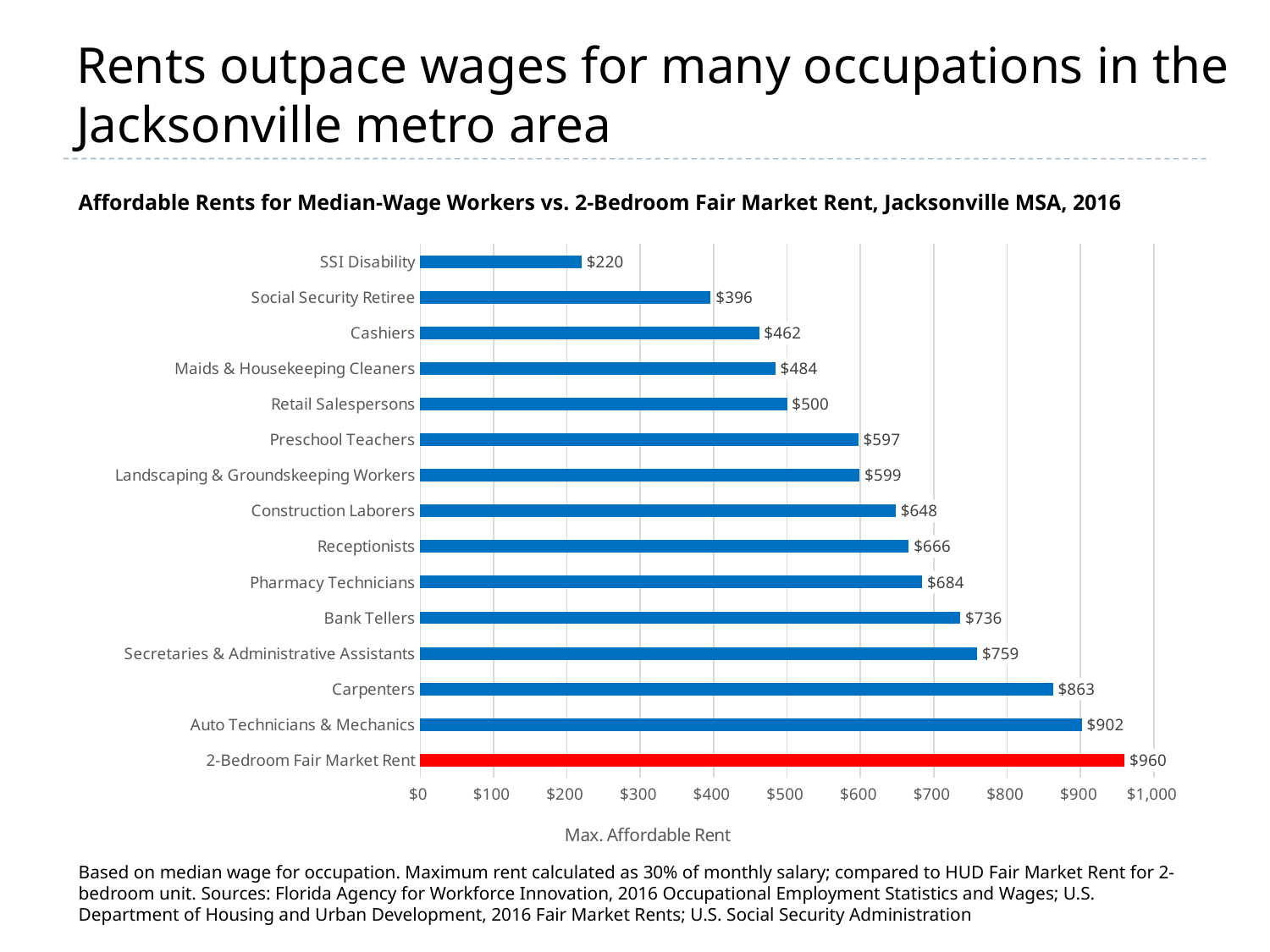
Which is larger, the value for Preschool Teachers or the value for Construction Laborers? Construction Laborers How many categories are plotted on the chart? 15 What kind of chart is shown on the slide? Bar chart What is the difference between the values for Carpenters and Receptionists? $197 Which category has the highest value on the chart? 2-Bedroom Fair Market Rent Which bar is shown in red rather than blue? 2-Bedroom Fair Market Rent Is the value for Secretaries & Administrative Assistants greater or less than $700? greater What is the maximum affordable rent for Cashiers? $462 What is the difference between the 2-Bedroom Fair Market Rent and the maximum affordable rent for Auto Technicians & Mechanics? $58 Which category has the lowest value on the chart? SSI Disability What is the value shown for Bank Tellers? $736 What is the 2-Bedroom Fair Market Rent shown on the chart? $960